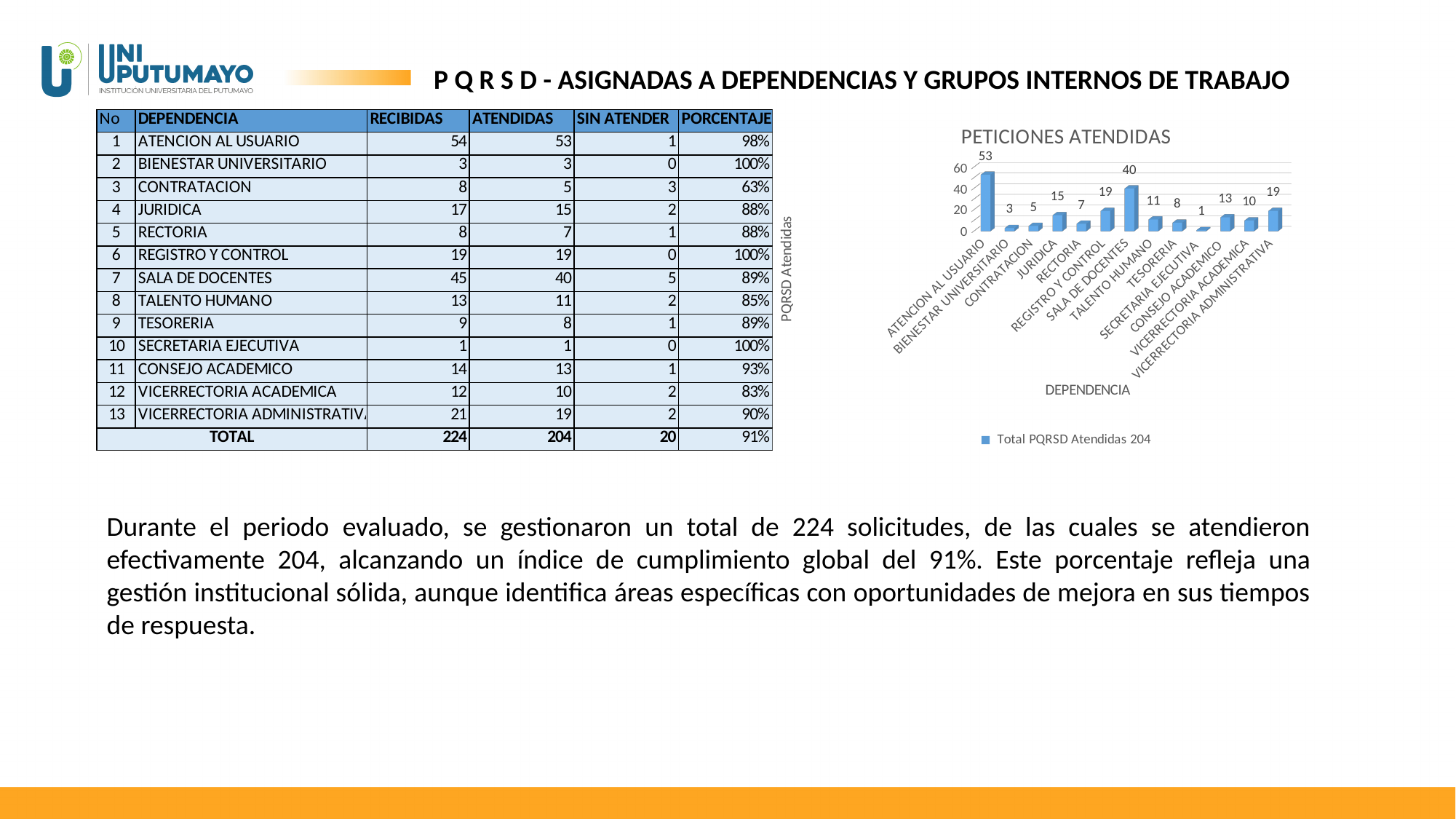
What is the legend entry shown in the chart? Total PQRSD Atendidas 204 Which dependencia has the highest value in the chart? ATENCION AL USUARIO What is the value for SALA DE DOCENTES in the chart? 40 Which dependencia has the lowest value in the chart? SECRETARIA EJECUTIVA What is the title of the chart? PETICIONES ATENDIDAS What type of chart is shown on the slide? bar chart Which has a larger value, TALENTO HUMANO or CONSEJO ACADEMICO? CONSEJO ACADEMICO What is the value for JURIDICA in the chart? 15 How many categories (dependencias) are plotted in the chart? 13 How many series does the chart legend list? 1 What is the value for ATENCION AL USUARIO in the chart? 53 What is the difference between the values for ATENCION AL USUARIO and SALA DE DOCENTES? 13